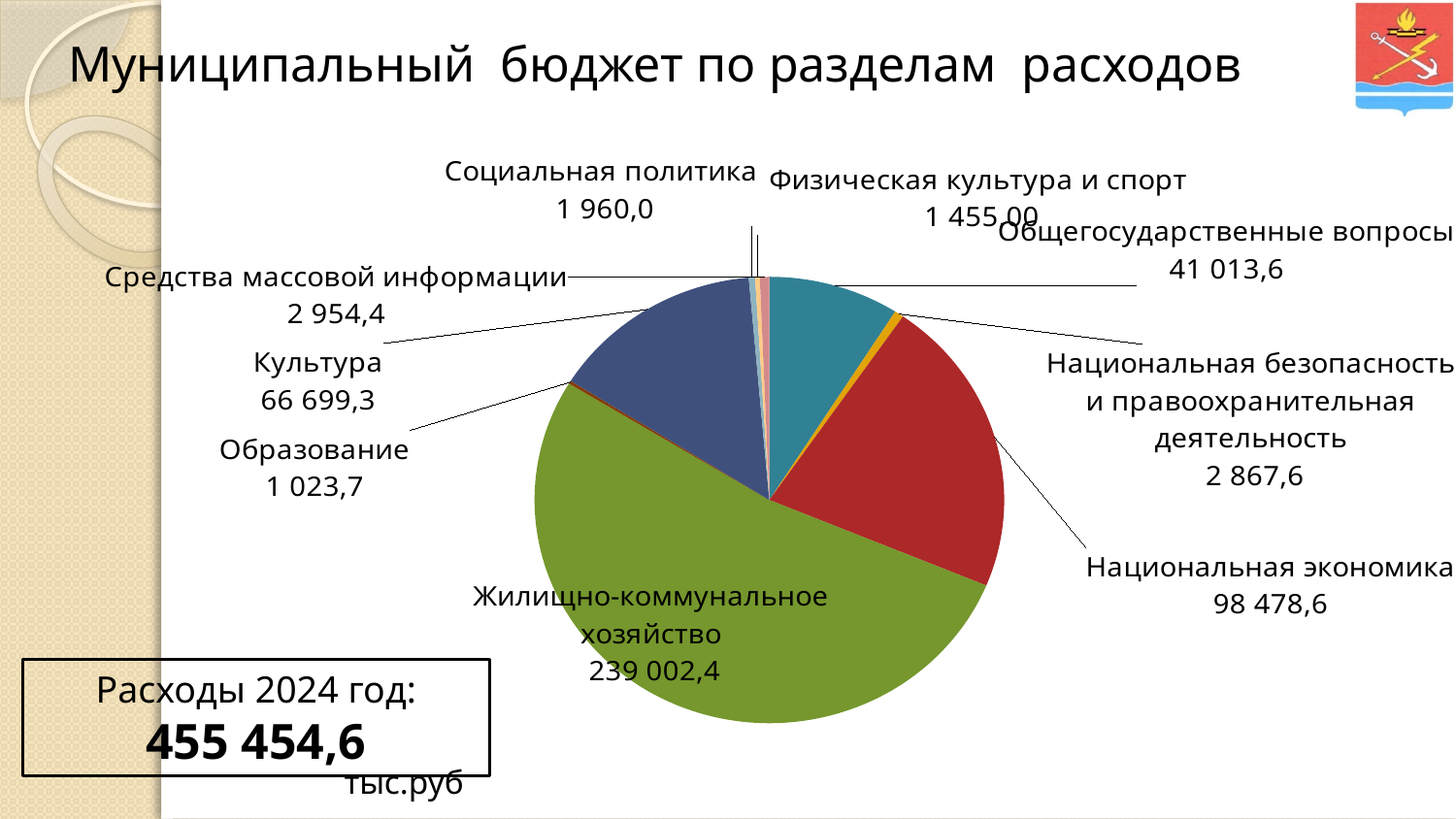
What is the value for Национальная экономика? 98 478,6 Which category has the largest slice of the pie? Жилищно-коммунальное хозяйство What is the difference between Национальная экономика and Культура? 31 779,3 How many categories are shown in the pie chart? 9 Which is larger: Средства массовой информации or Национальная безопасность и правоохранительная деятельность? Средства массовой информации What is the value for Жилищно-коммунальное хозяйство? 239 002,4 What is the value for Культура? 66 699,3 What is the value for Общегосударственные вопросы? 41 013,6 Which category has the smallest value? Образование What total expenditure for 2024 is shown in the box on the slide? 455 454,6 тыс.руб Is the Жилищно-коммунальное хозяйство slice more or less than half of the pie? More What type of chart is shown on the slide? Pie chart